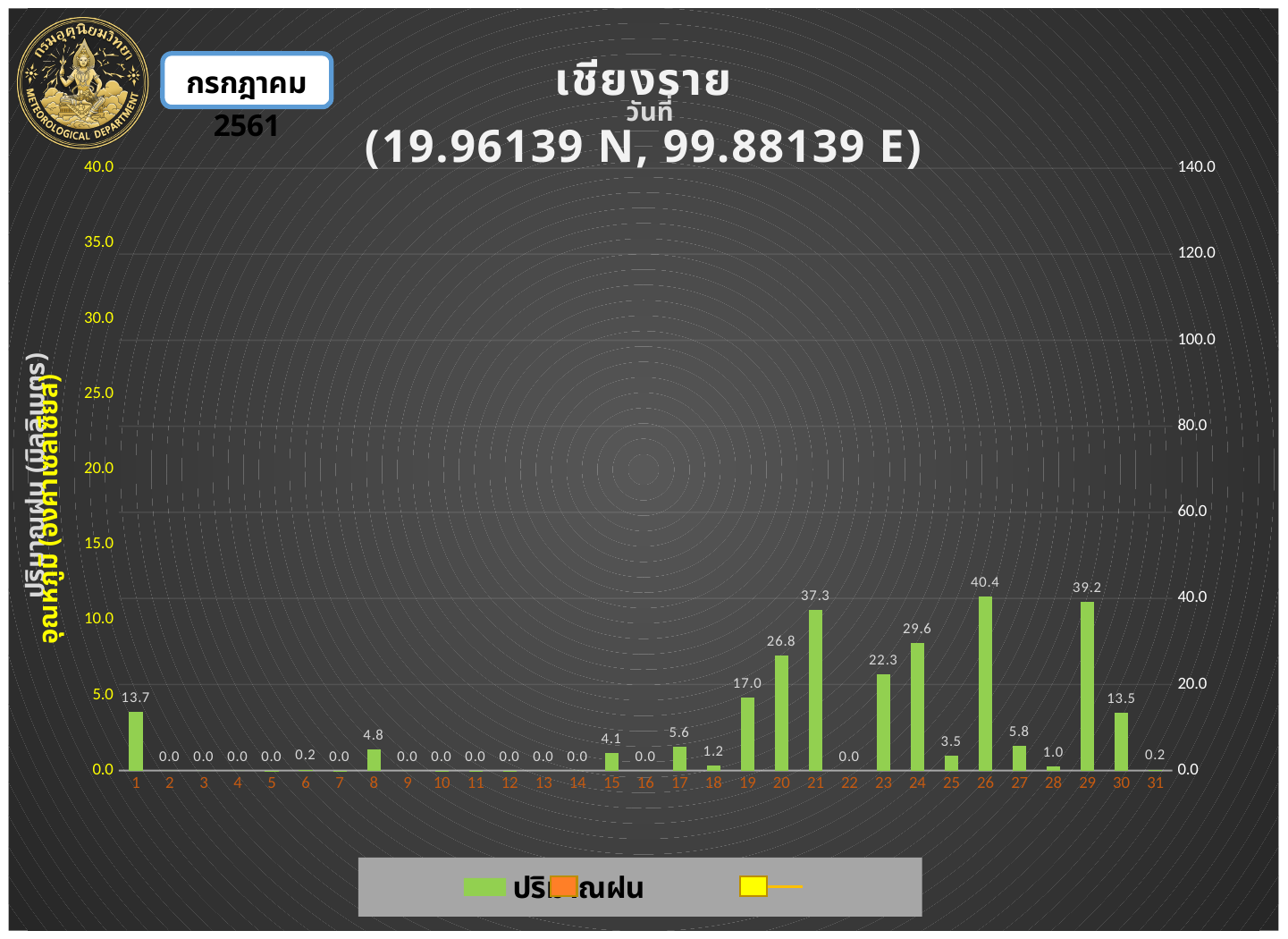
What colour are the rainfall bars? green What kind of chart is used to show the rainfall values? bar chart Which day has the highest rainfall value? 26 What is the rainfall value shown for day 21? 37.3 Which day has the larger rainfall value, day 21 or day 24? 21 What is the difference between the rainfall values for day 26 and day 29? 1.2 Do the rainfall values rise or fall from day 19 to day 21? rise What is the rainfall value shown for day 1? 13.7 How many days are shown on the x axis? 31 What is the rainfall value shown for day 8? 4.8 Is the rainfall value for day 21 greater or less than 20.0 on the right axis? greater What is the rainfall value shown for day 26? 40.4